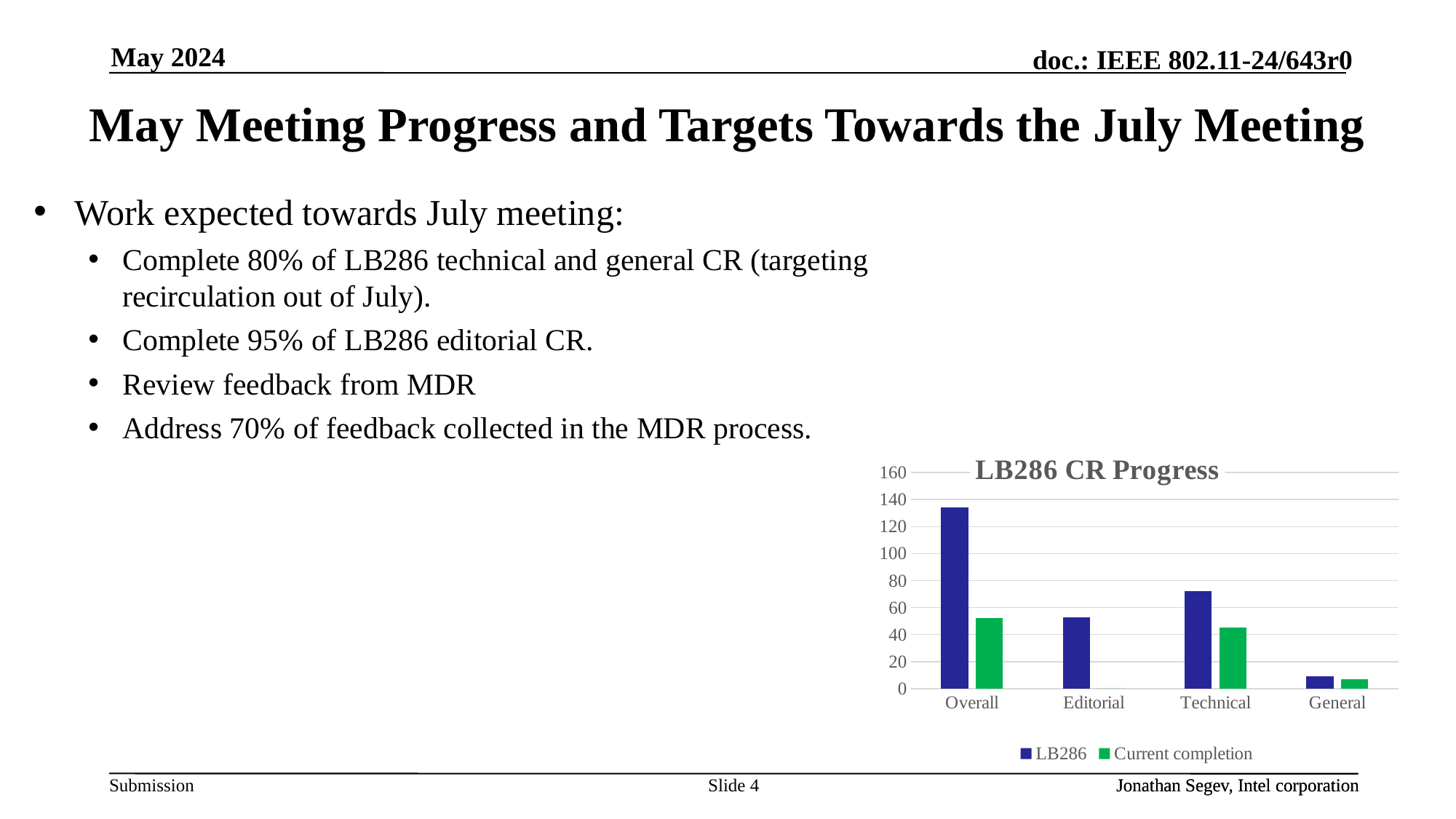
What kind of chart is shown on the slide? Bar chart Which category has the lowest LB286 value? General Which category has the highest LB286 value? Overall Is the Current completion value for Overall greater or less than 60? less What is the title of the chart? LB286 CR Progress Which colour represents the Current completion series in the chart? Green Which is larger, the LB286 value for Technical or the LB286 value for Editorial? Technical How many series does the chart legend list? 2 Is the LB286 value for General greater or less than 20? less Is the LB286 value for Overall greater or less than 120? greater How many categories are shown on the x axis of the chart? 4